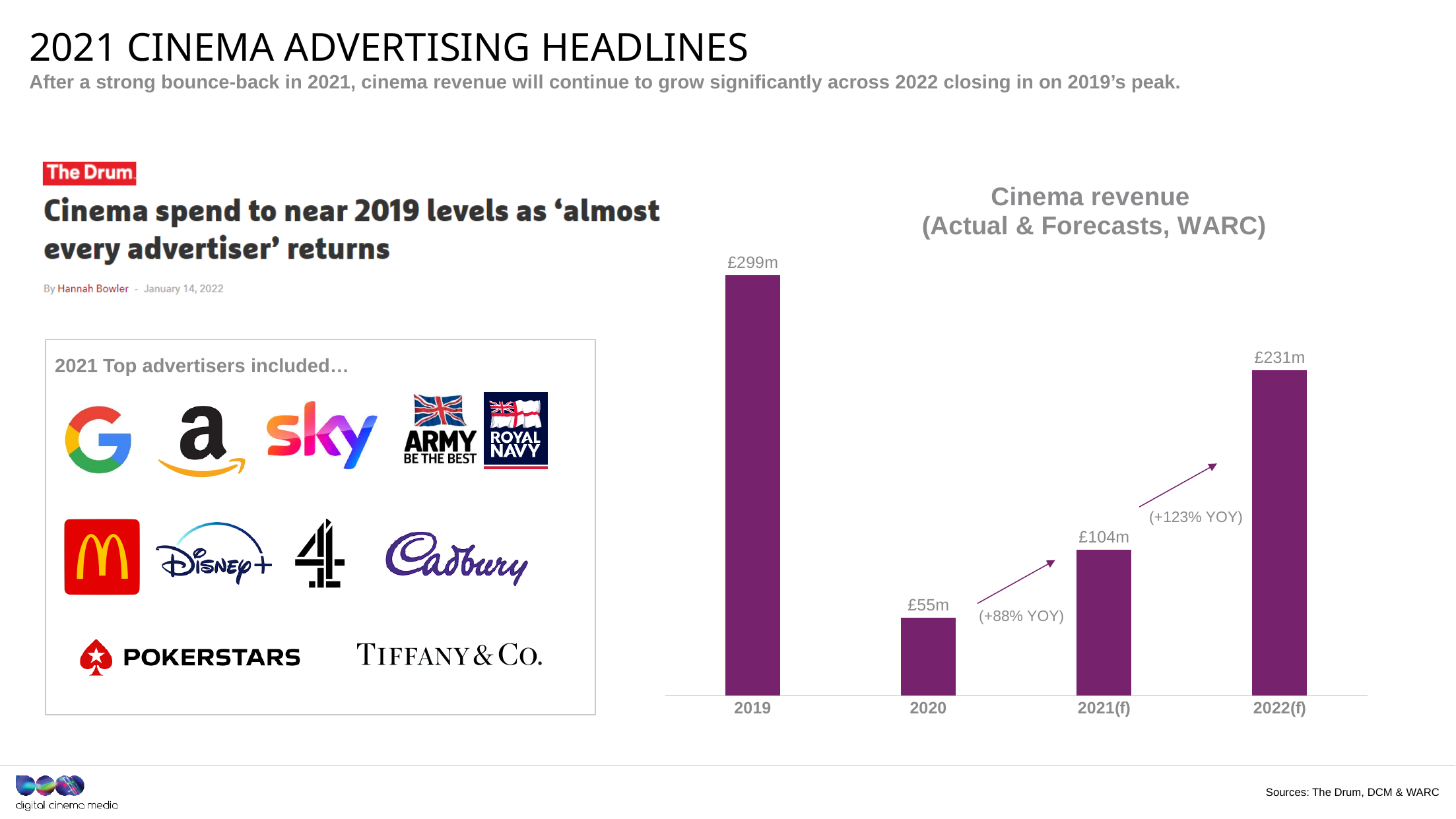
What is the cinema revenue value shown for 2020? £55m Which year has the lowest cinema revenue in the chart? 2020 What is the cinema revenue value shown for 2019? £299m How many years are shown on the x axis of the cinema revenue chart? 4 What year-on-year growth is annotated between 2021(f) and 2022(f)? +123% YOY Which is larger, the cinema revenue for 2021(f) or for 2022(f)? 2022(f) Which year has the highest cinema revenue in the chart? 2019 What is the difference between the cinema revenue for 2021(f) and 2020? £49m What kind of chart is used to show cinema revenue? Bar chart What is the cinema revenue value shown for 2022(f)? £231m What is the cinema revenue value shown for 2021(f)? £104m What is the difference between the cinema revenue for 2019 and 2022(f)? £68m